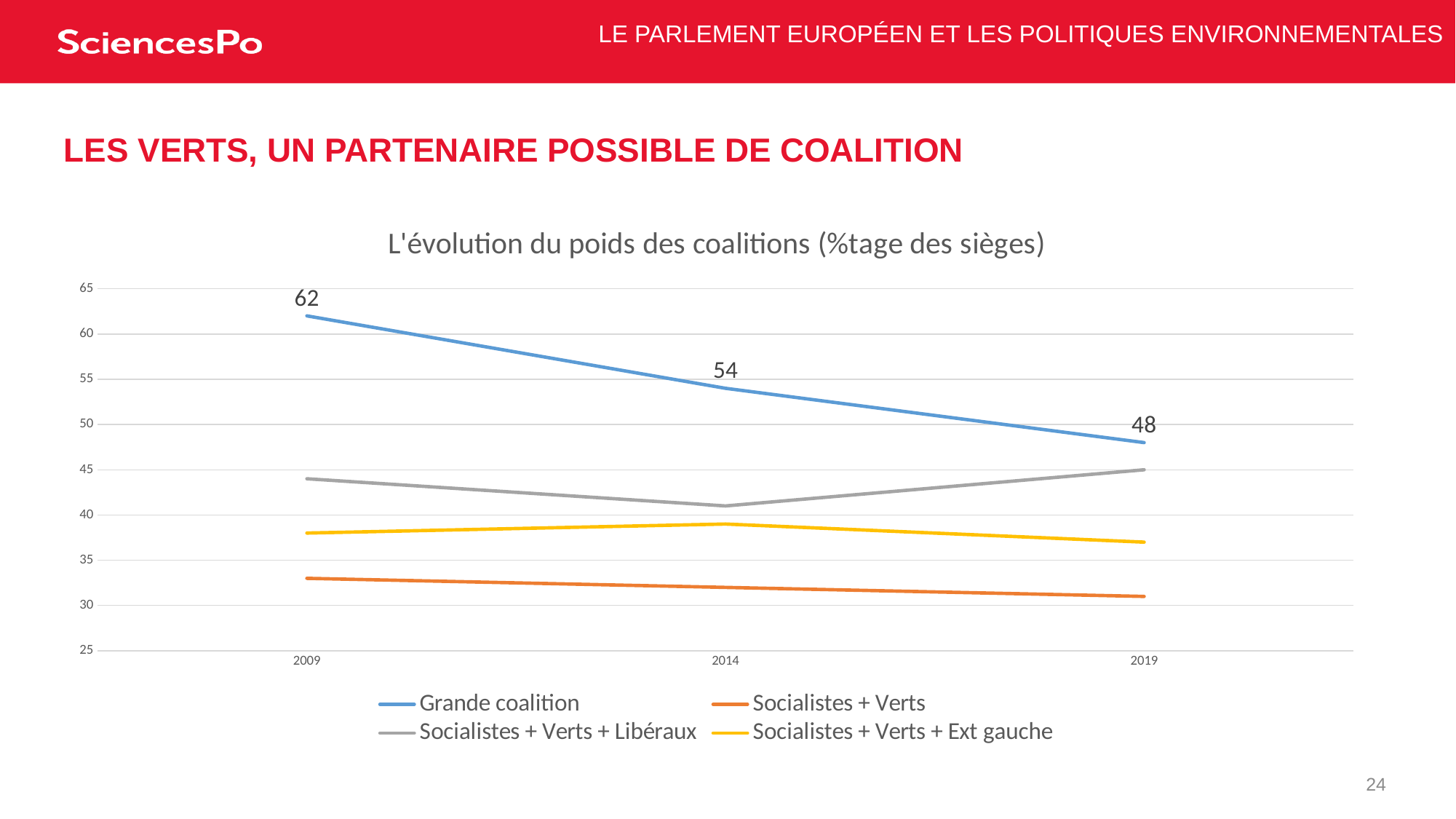
Is the value for Socialistes + Verts + Libéraux in 2019 greater or less than 40? greater How many series does the legend list? 4 Is the value for Socialistes + Verts in 2009 greater or less than 35? less What is the value for Grande coalition in 2009? 62 Which series has the highest value in 2019? Grande coalition Which series has the lowest value in 2009? Socialistes + Verts What is the difference between the Grande coalition values in 2009 and 2014? 8 What kind of chart is shown on the slide? line chart Does the Grande coalition line rise or fall from 2009 to 2019? fall What is the value for Grande coalition in 2014? 54 By how much did the Grande coalition value fall between 2009 and 2019? 14 What is the value for Grande coalition in 2019? 48